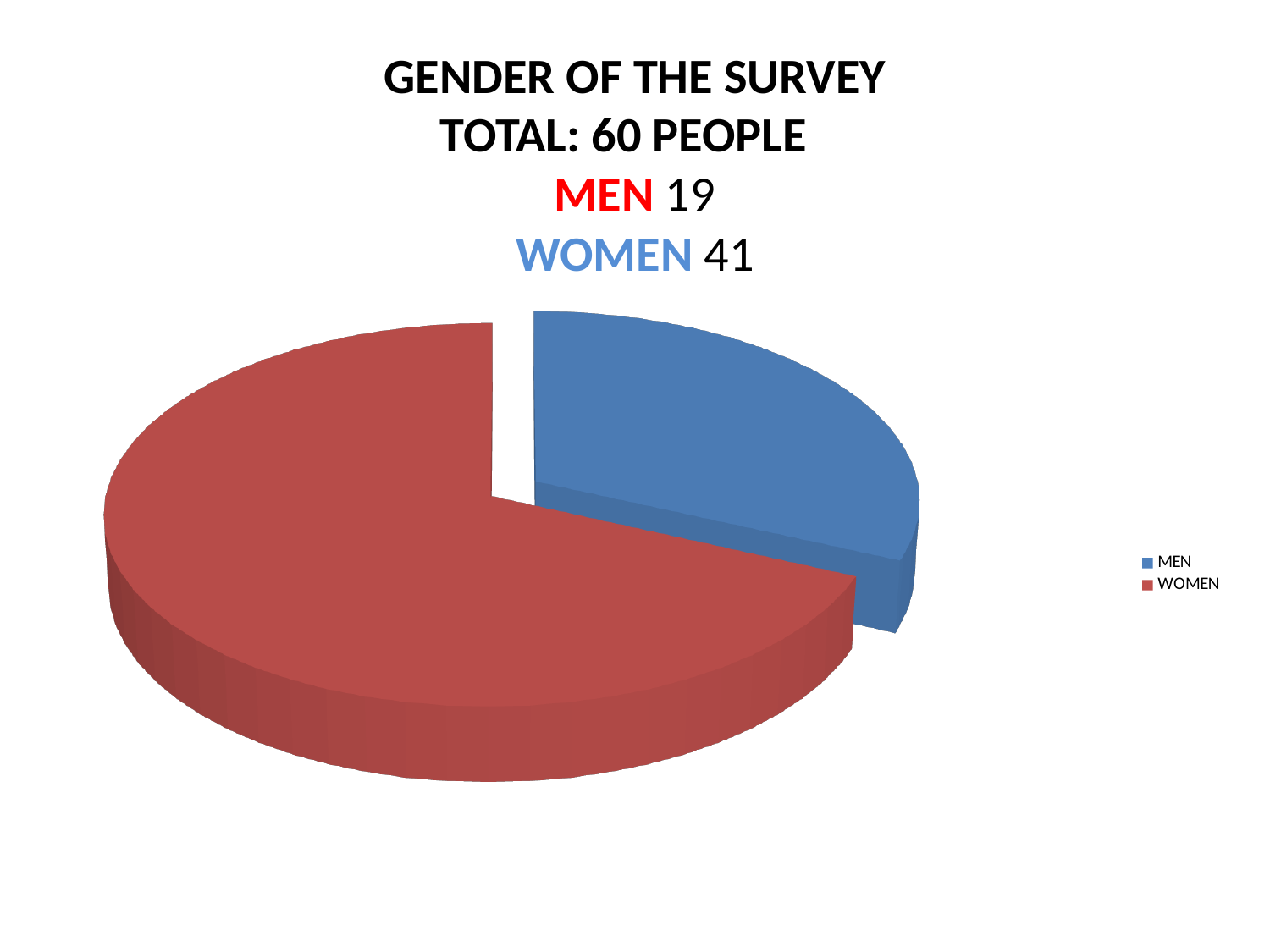
Which category has the smaller slice of the pie? MEN What is the difference between the number of WOMEN and the number of MEN? 22 What is the first line of the chart title? GENDER OF THE SURVEY Is the value for WOMEN larger than the value for MEN? Yes What is the total number of people surveyed? 60 What type of chart is shown on the slide? pie chart How many people are WOMEN according to the slide? 41 How many entries does the legend list? 2 How many slices does the pie chart have? 2 Which category has the larger slice of the pie, MEN or WOMEN? WOMEN Which colour represents WOMEN in the pie chart? red How many people are MEN according to the slide? 19